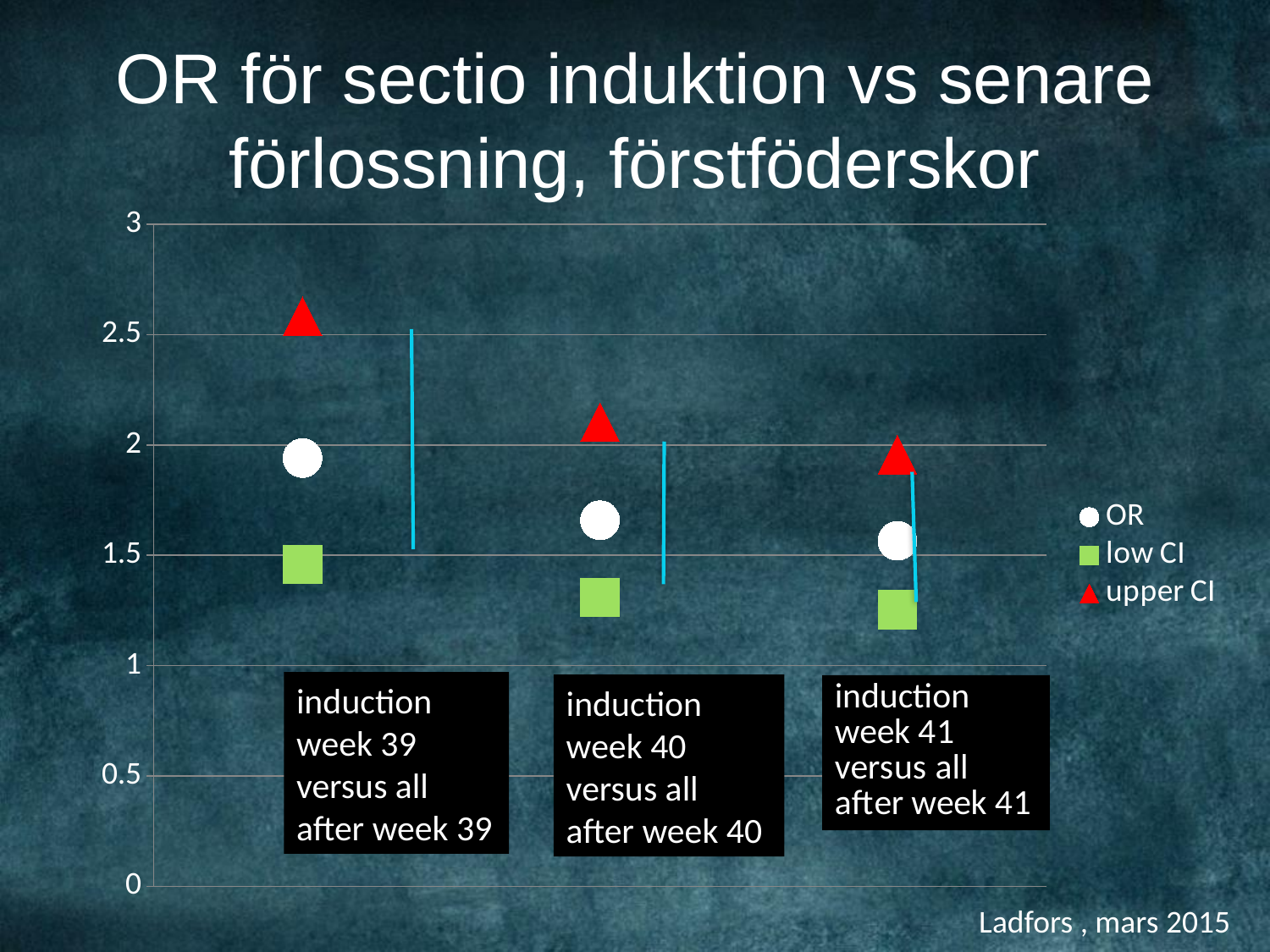
What kind of chart is shown on the slide? scatter chart How many induction-week categories are plotted on the chart? 3 Do the OR values rise or fall from induction week 39 to induction week 41? fall Which category has the highest OR value? induction week 39 versus all after week 39 Which is larger, the upper CI for induction week 39 or the upper CI for induction week 41? induction week 39 Is the OR value for induction week 39 greater or less than 1.5? greater What are the three entries listed in the chart legend? OR, low CI, upper CI How many series does the legend list? 3 Is the low CI value for induction week 40 greater or less than 1.5? less Is the upper CI value for induction week 39 greater or less than 2.5? greater Which category has the lowest upper CI value? induction week 41 versus all after week 41